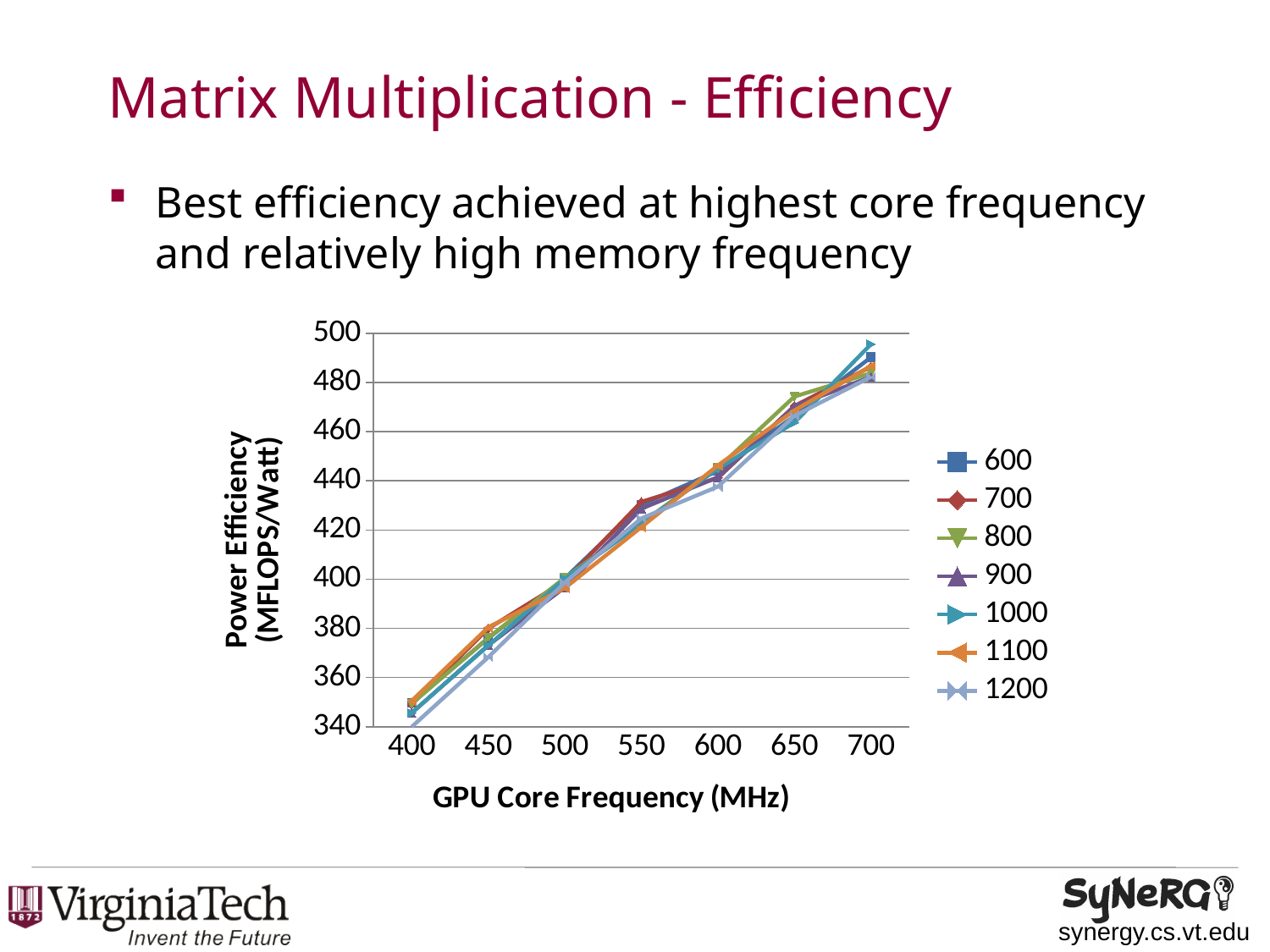
How many series does the legend list? 7 Is the value for the 800 series at 650 MHz greater or less than 460? greater Is the value for the 1200 series at 550 MHz greater or less than 440? less Is the value for the 1100 series at 450 MHz greater or less than 400? less What is the title of the x axis? GPU Core Frequency (MHz) Do the power efficiency values rise or fall as GPU core frequency increases? rise What kind of chart is shown on the slide? line chart How many GPU core frequency values are plotted along the x axis? 7 What is the title of the y axis? Power Efficiency (MFLOPS/Watt)